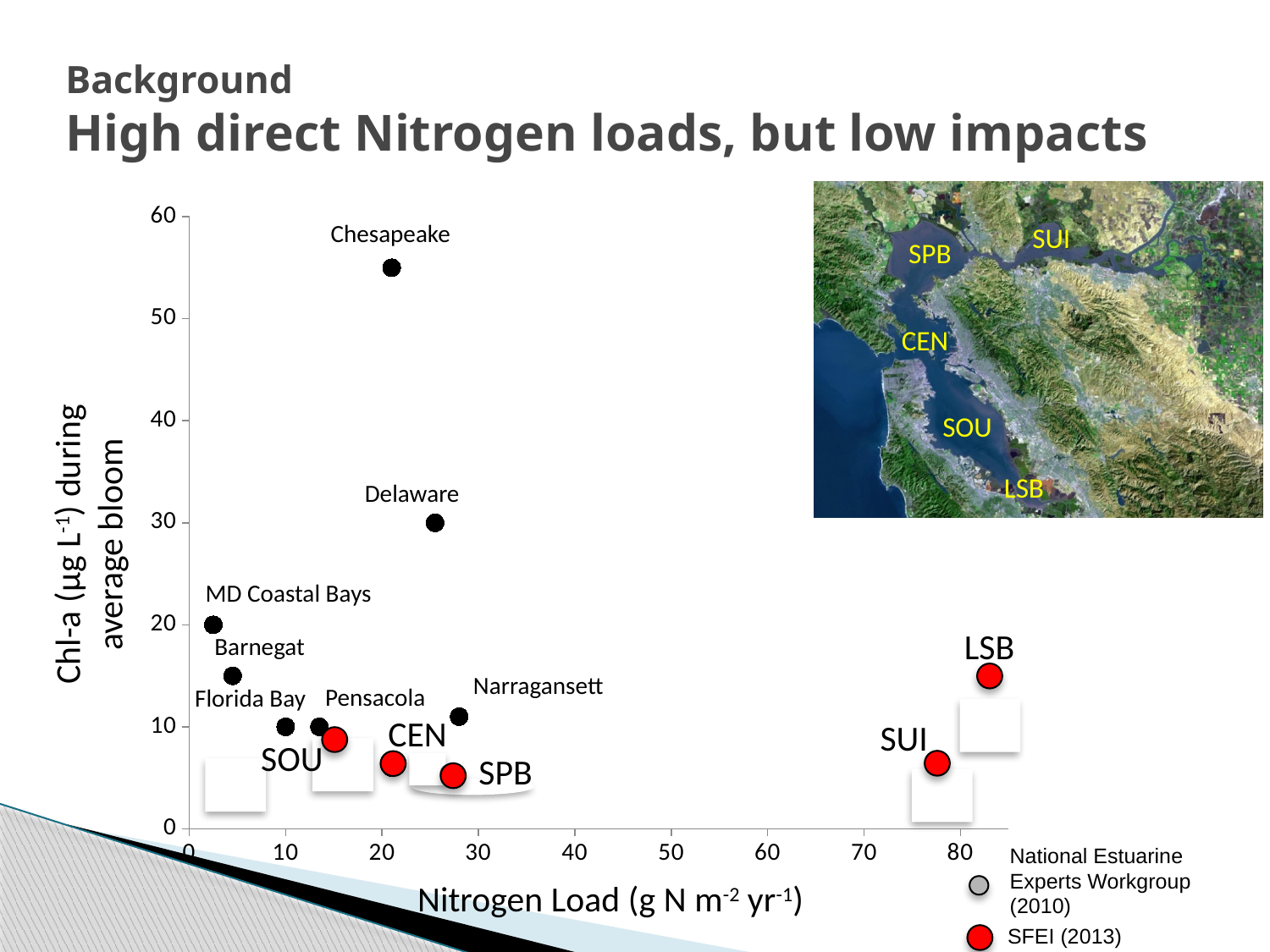
What is the label of the x axis? Nitrogen Load (g N m-2 yr-1) Which has the higher Chl-a value, LSB or SUI? LSB Which estuary has the highest Chl-a during average bloom? Chesapeake How many series does the legend list? 2 Is the Nitrogen Load for LSB greater or less than 80? greater What is the Chl-a value for Delaware? 30 Which estuary has the highest Nitrogen Load? LSB Is the Nitrogen Load for SUI greater or less than 70? greater What kind of chart is shown on the slide? scatter chart Is the Chl-a value for Chesapeake greater or less than 50? greater Which has the higher Chl-a value, Chesapeake or Delaware? Chesapeake